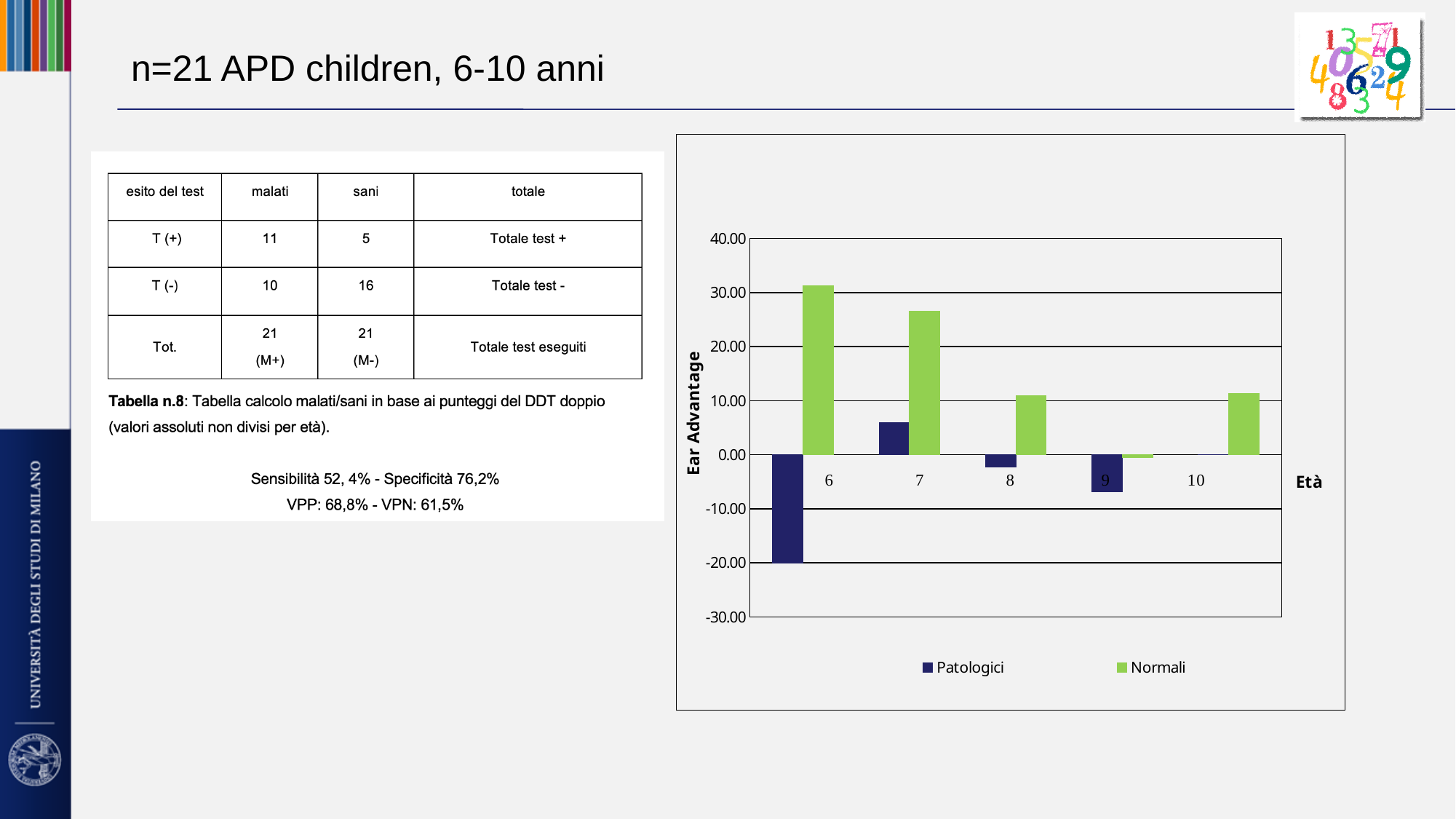
What is the label of the vertical axis of the chart? Ear Advantage What are the two series named in the chart legend? Patologici and Normali How many age categories are shown on the x axis of the chart? 5 Is the Patologici value for age 6 greater or less than -10.00? less Is the Patologici value for age 9 greater or less than 0.00? less Is the Normali value for age 6 greater or less than 30.00? greater For which age is the Patologici bar the lowest? 6 How many series does the chart legend list? 2 What kind of chart is shown on the slide? bar chart For which age is the Normali bar the highest? 6 Which is larger, the Normali value for age 6 or the Normali value for age 7? age 6